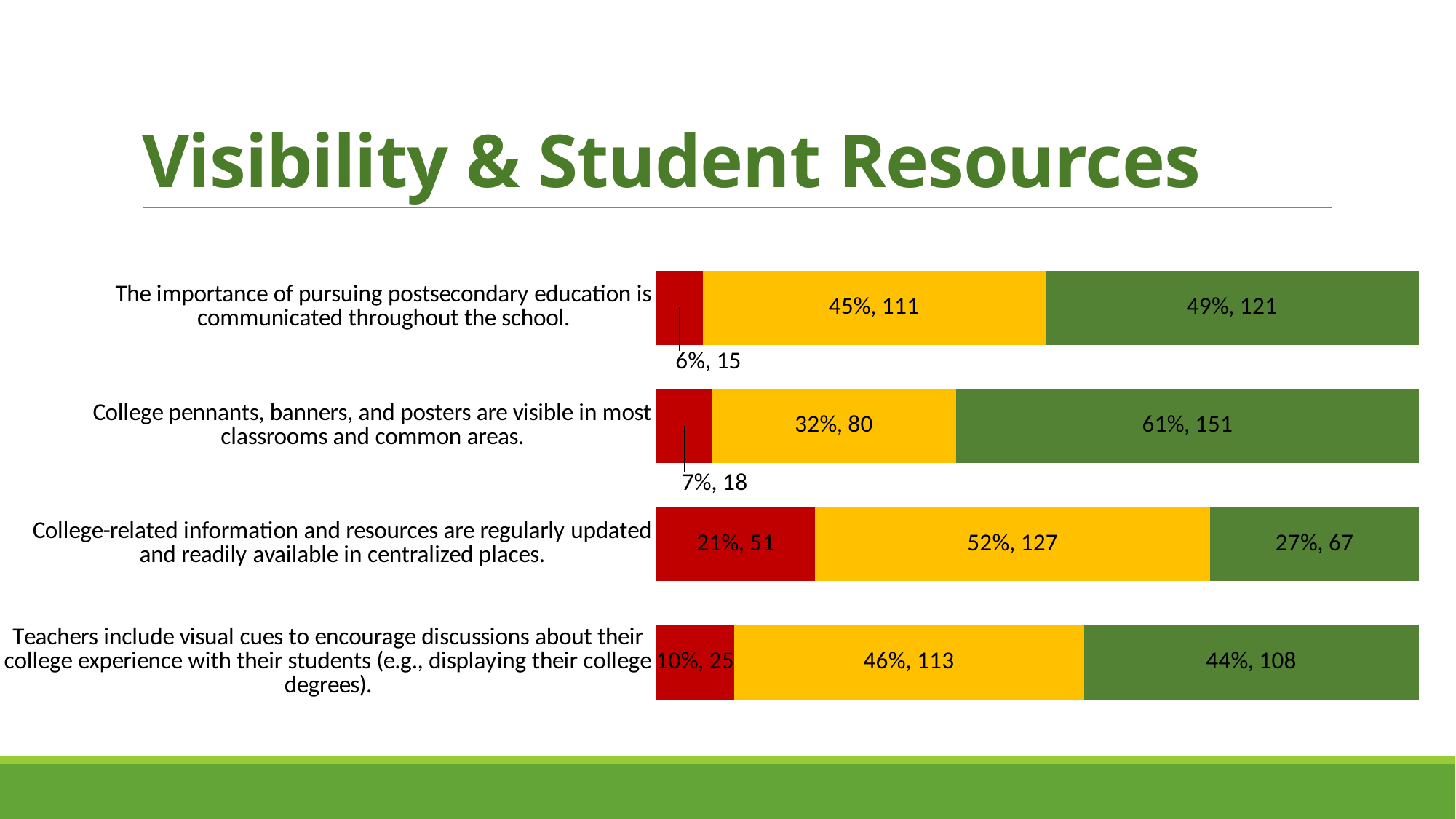
Which statement has the largest green segment? College pennants, banners, and posters are visible in most classrooms and common areas. What three colours are used for the segments of the bars? Red, yellow and green What is the data label on the green segment for "College pennants, banners, and posters are visible in most classrooms and common areas"? 61%, 151 What is the data label on the red segment for "College-related information and resources are regularly updated and readily available in centralized places"? 21%, 51 For "College pennants, banners, and posters are visible in most classrooms and common areas", how many more responses are in the green segment than in the yellow segment? 71 What kind of chart is shown on the slide? Stacked horizontal bar chart How many statements (categories) are plotted in the chart? 4 What is the total number of responses across all three segments for "College pennants, banners, and posters are visible in most classrooms and common areas"? 249 Which statement has the smallest red segment? The importance of pursuing postsecondary education is communicated throughout the school. What is the data label on the yellow segment for "Teachers include visual cues to encourage discussions about their college experience with their students"? 46%, 113 Which statement has the largest yellow segment? College-related information and resources are regularly updated and readily available in centralized places. For "Teachers include visual cues to encourage discussions about their college experience with their students", which segment has more responses, the yellow or the green? Yellow